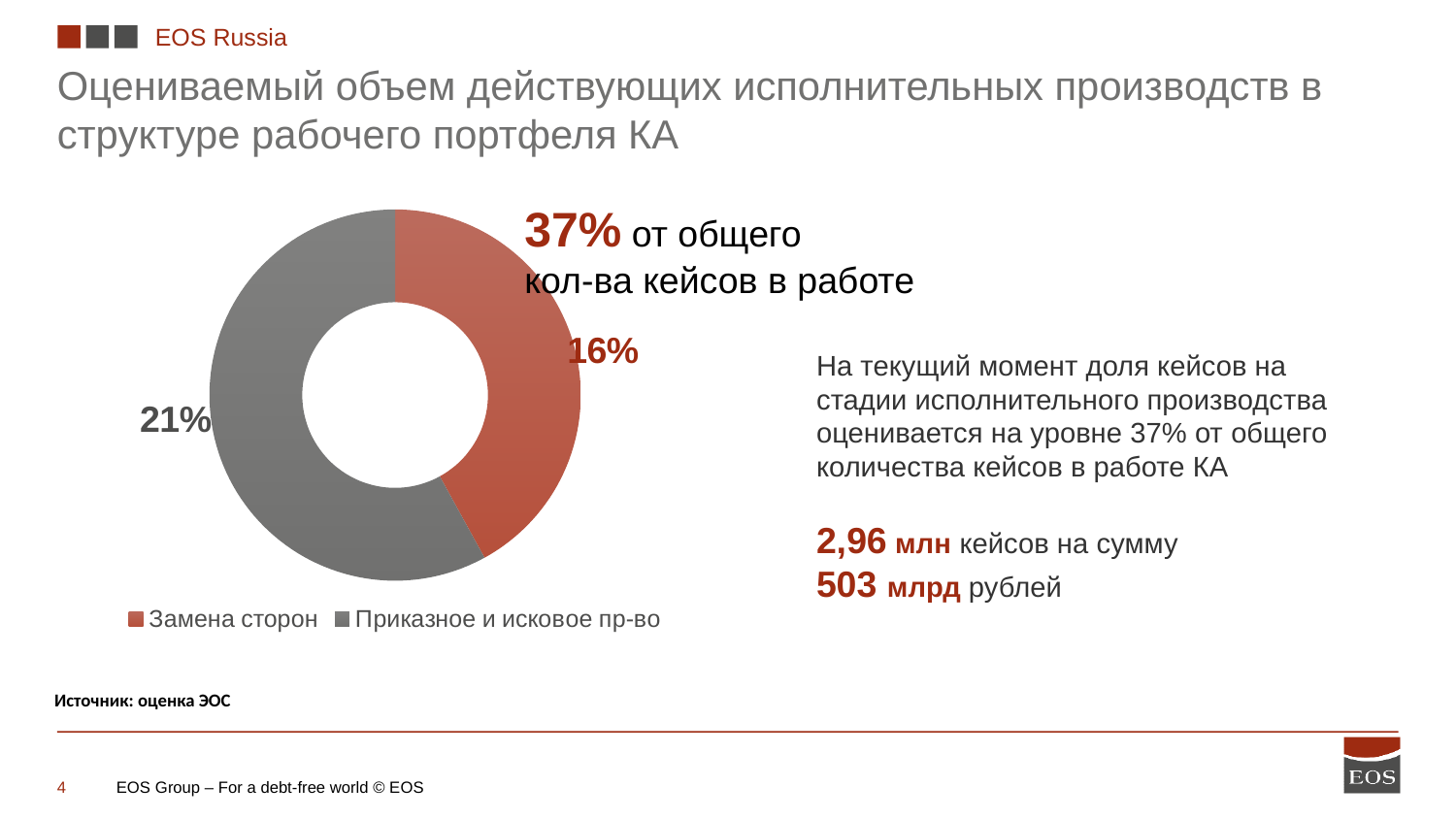
What is the sum of the two labelled slices, 16% and 21%? 37% Which category has the larger slice in the chart? Приказное и исковое пр-во What kind of chart is shown on the slide? Donut (pie) chart Which category has the smaller slice in the chart? Замена сторон What value is shown for the 'Замена сторон' slice? 16% How many categories does the legend of the chart list? 2 Which colour represents 'Замена сторон' in the chart? Red Which colour represents 'Приказное и исковое пр-во' in the chart? Grey What value is shown for the 'Приказное и исковое пр-во' slice? 21% What is the difference in percentage points between 'Приказное и исковое пр-во' (21%) and 'Замена сторон' (16%)? 5 percentage points Is the value for 'Приказное и исковое пр-во' larger or smaller than the value for 'Замена сторон'? Larger